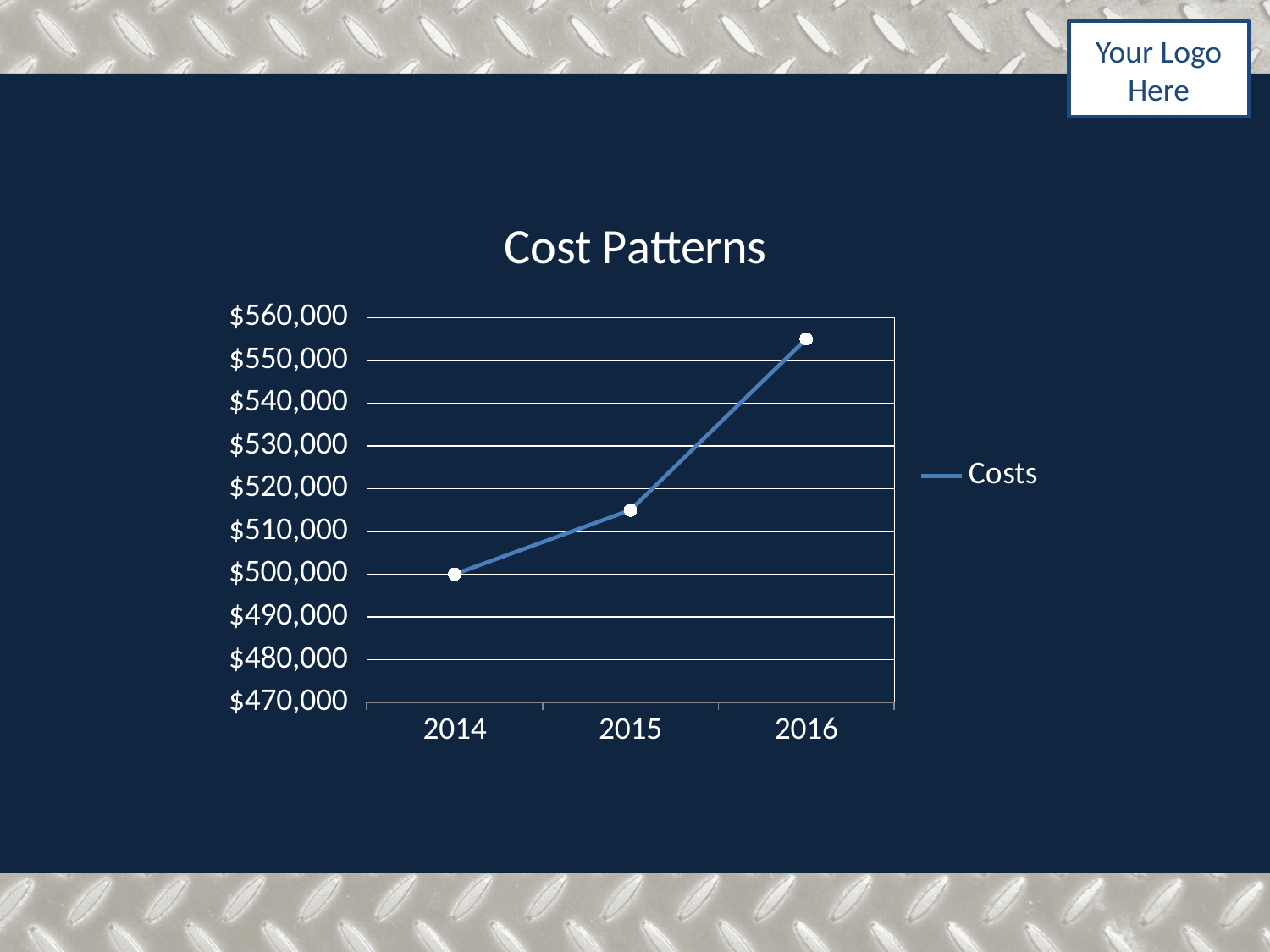
What is the value of Costs for 2014? $500,000 Is the Costs value for 2016 greater or less than $550,000? greater How many years are plotted on the x axis? 3 Do the Costs values rise or fall from 2014 to 2016? rise Which year has the highest Costs value? 2016 Which year has the lowest Costs value? 2014 Which year has the larger Costs value, 2015 or 2016? 2016 What is the title of the chart? Cost Patterns How many series does the legend list? 1 Is the Costs value for 2015 greater or less than $510,000? greater What is the name of the series shown in the legend? Costs What type of chart is shown on the slide? line chart